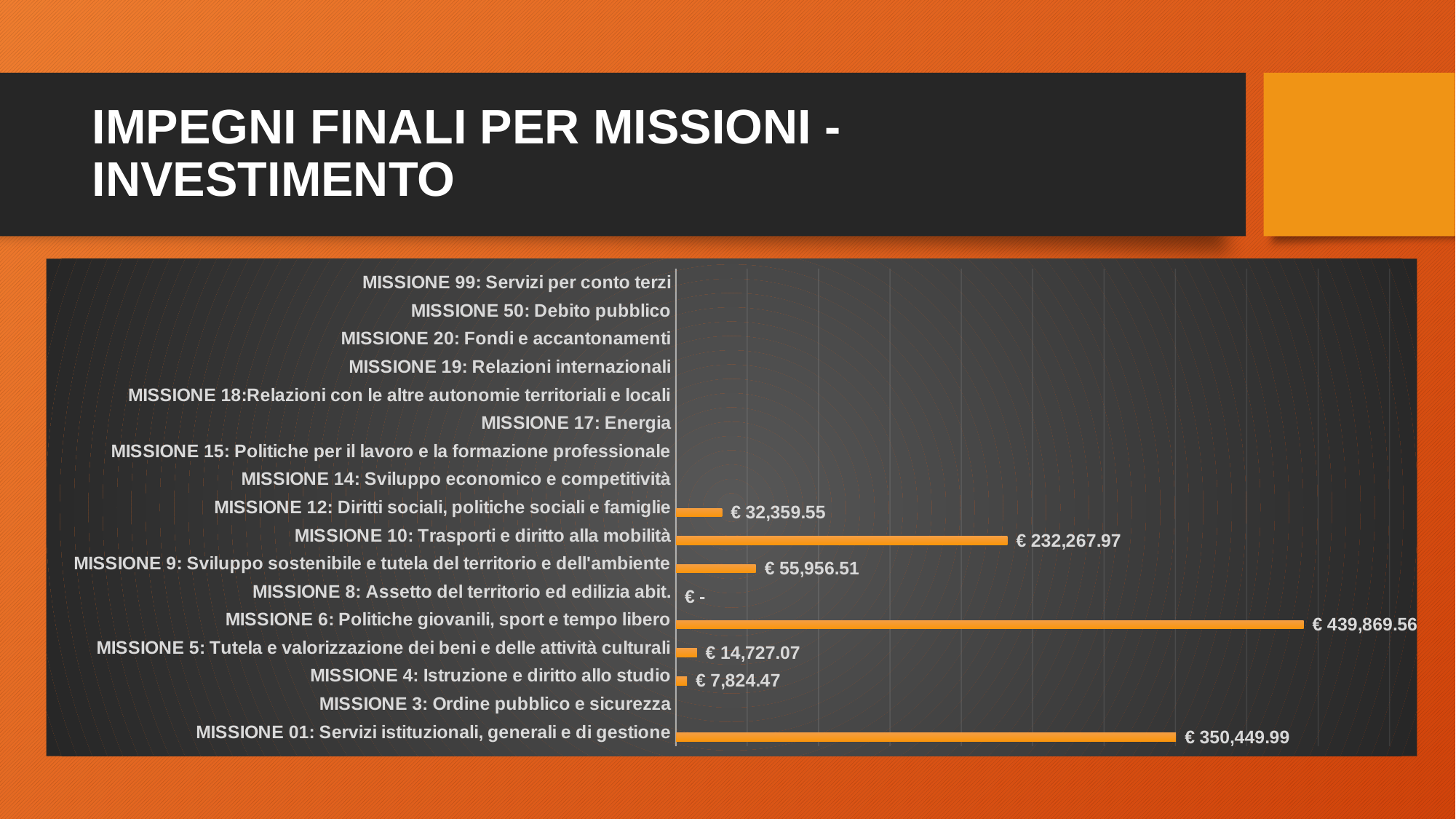
Which mission has the highest value? MISSIONE 6: Politiche giovanili, sport e tempo libero What is the difference between the values for MISSIONE 6 and MISSIONE 01? € 89,419.57 What is the difference between the values for MISSIONE 10 and MISSIONE 9? € 176,311.46 How many mission categories are listed on the chart? 17 Among the missions with a non-zero bar, which has the lowest value? MISSIONE 4: Istruzione e diritto allo studio What kind of chart is shown on the slide? Bar chart What is the value for MISSIONE 6: Politiche giovanili, sport e tempo libero? € 439,869.56 What is the value for MISSIONE 10: Trasporti e diritto alla mobilità? € 232,267.97 What is the value for MISSIONE 4: Istruzione e diritto allo studio? € 7,824.47 What is the title of the slide? IMPEGNI FINALI PER MISSIONI - INVESTIMENTO What is the value for MISSIONE 01: Servizi istituzionali, generali e di gestione? € 350,449.99 Which is larger, the value for MISSIONE 12 or the value for MISSIONE 5? MISSIONE 12